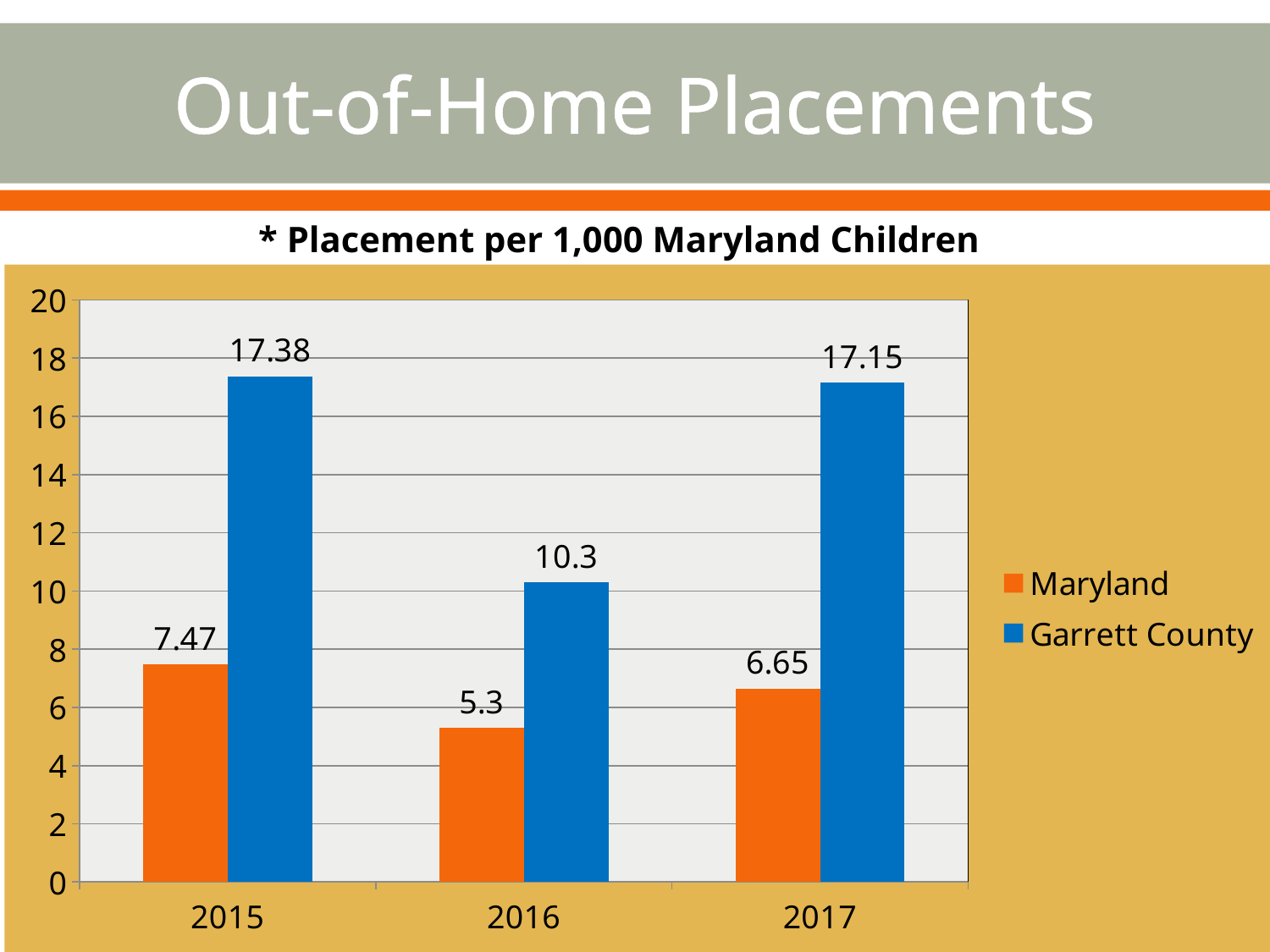
What is the Maryland value for 2016? 5.3 Is the Garrett County value for 2016 greater or less than 8? greater What is the Maryland value for 2015? 7.47 In which year is the Garrett County value highest? 2015 How many series does the legend list? 2 What is the difference between the Garrett County and Maryland values in 2015? 9.91 What is the Garrett County value for 2016? 10.3 Which is larger in 2017, the Maryland value or the Garrett County value? Garrett County What is the Garrett County value for 2017? 17.15 How many years are shown on the x axis? 3 In which year is the Maryland value lowest? 2016 What kind of chart is shown on the slide? Bar chart